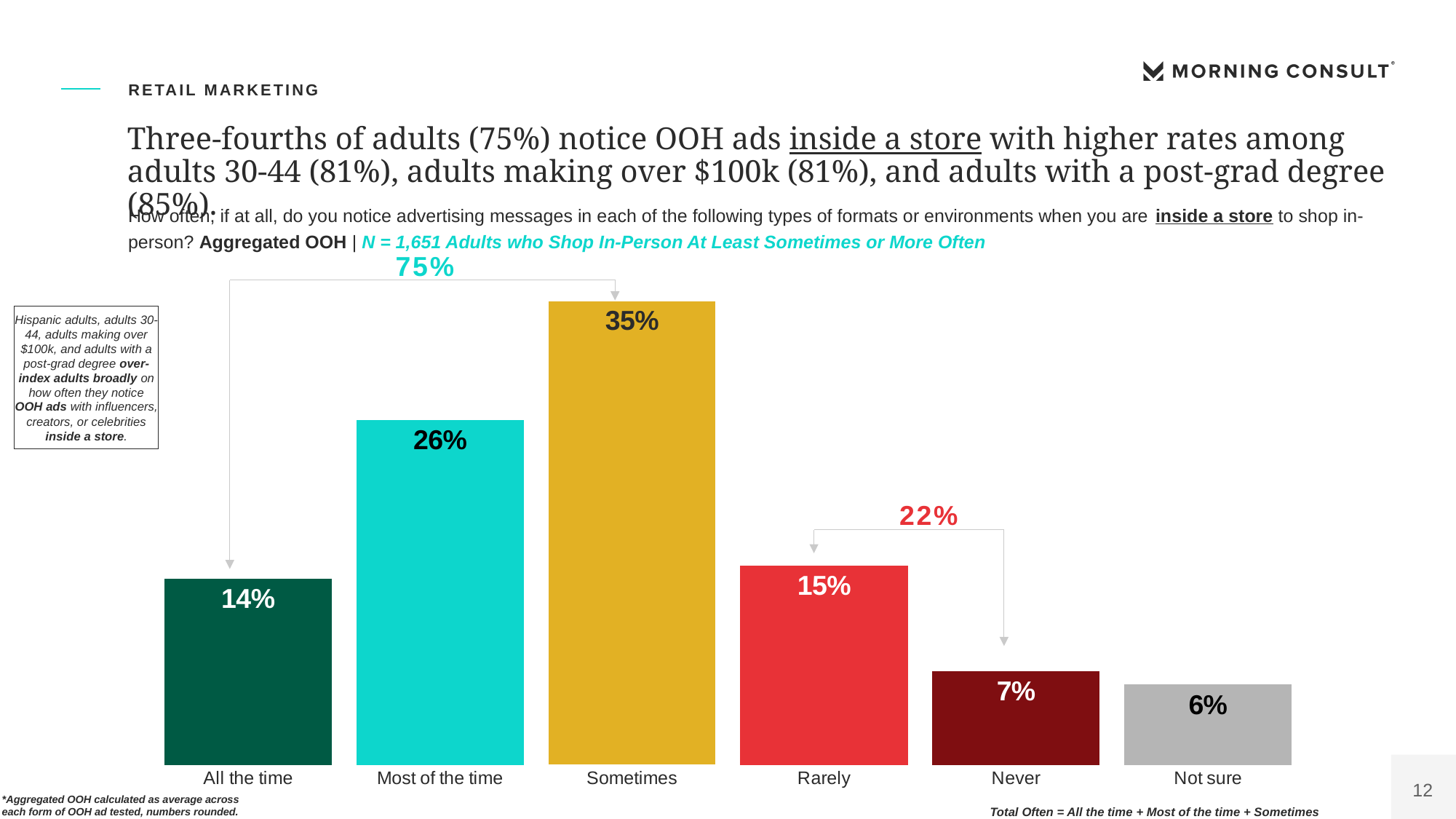
Which category has the highest value in the chart? Sometimes What percentage is shown for 'Not sure'? 6% Which is larger, the value for 'Rarely' or the value for 'Never'? Rarely What is the difference between the 'Most of the time' and 'Rarely' values? 11 percentage points What combined percentage is shown by the bracket spanning 'All the time' through 'Sometimes'? 75% Which category has the lowest value in the chart? Not sure What type of chart is shown on the slide? Bar chart What combined percentage is shown by the bracket spanning 'Rarely' and 'Never'? 22% What is the value shown for 'All the time'? 14% How many categories are shown on the x axis of the chart? 6 What colour is the bar for 'Sometimes'? Yellow/gold What percentage of adults say they notice OOH ads inside a store 'Sometimes'? 35%